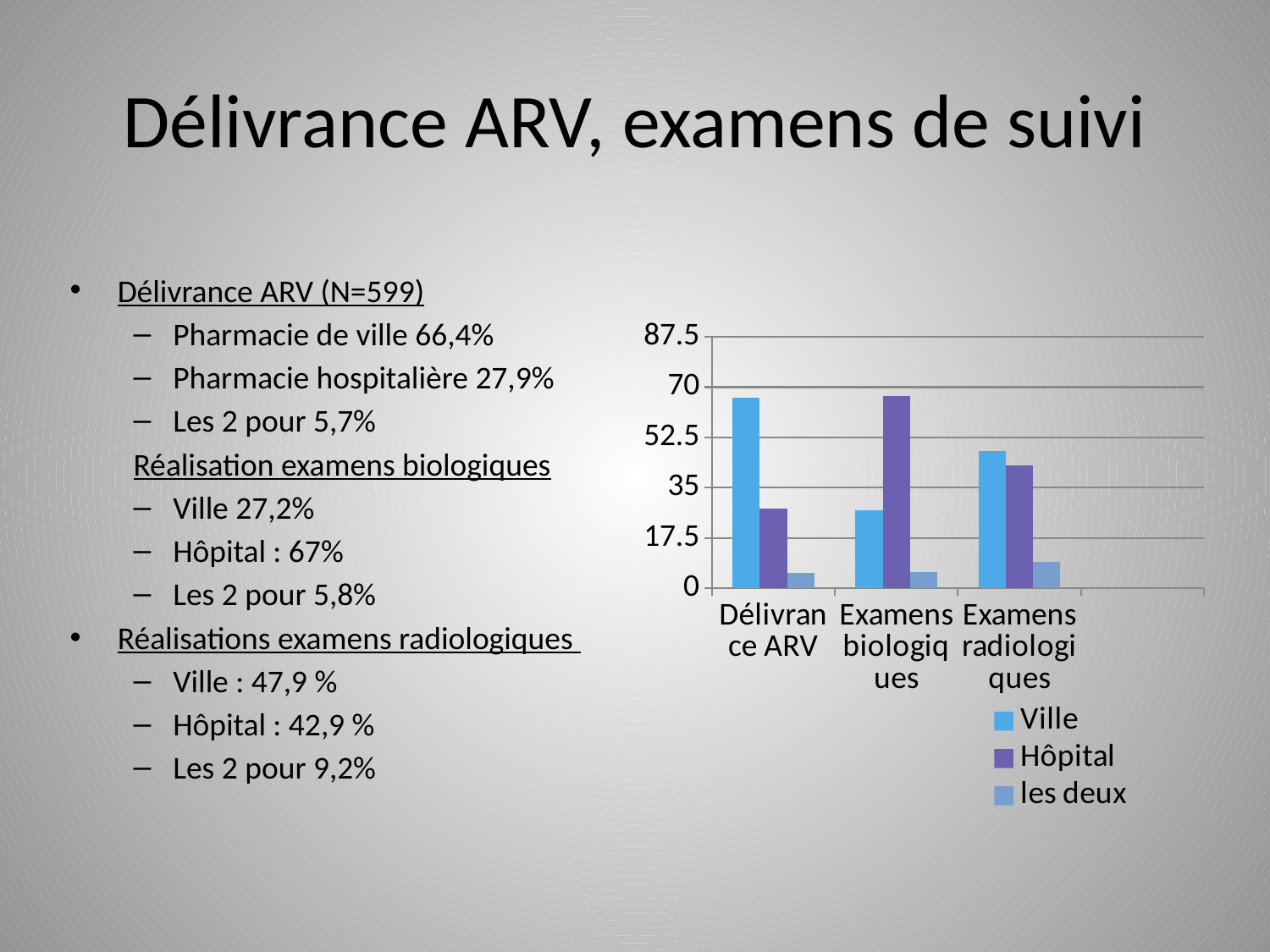
In which category is the Ville series highest? Délivrance ARV Is the Ville value for Délivrance ARV greater or less than 52.5? greater For Délivrance ARV, which is larger: Ville or Hôpital? Ville How many series does the chart legend list? 3 For Examens biologiques, which is larger: Ville or Hôpital? Hôpital Is the Hôpital value for Examens biologiques greater or less than 52.5? greater Is the Ville value for Examens biologiques greater or less than 35? less How many categories are shown on the x axis of the chart? 3 What kind of chart is shown on the slide? bar chart Which series is shown in the darker purple colour in the chart? Hôpital In which category is the Hôpital series lowest? Délivrance ARV